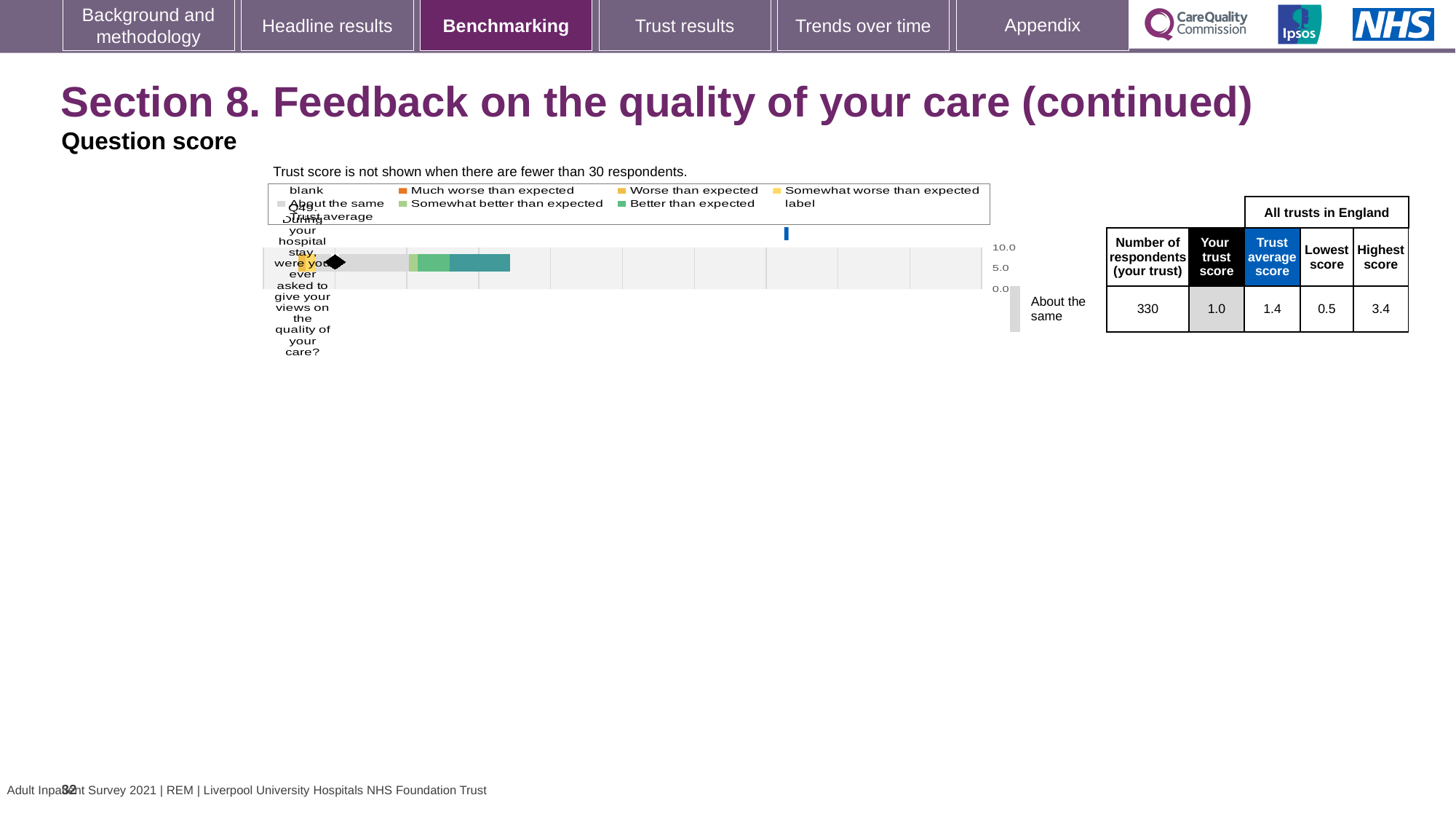
How many questions (categories) are plotted in the bar chart? 1 What benchmark category is shown beside the chart for Q49? About the same In the table next to the chart, what is the trust average score for Q49? 1.4 In the table next to the chart, what is your trust score for Q49? 1.0 Which question is plotted in the bar chart? Q49. During your hospital stay, were you ever asked to give your views on the quality of your care? In the table next to the chart, what is the number of respondents for your trust? 330 Which is larger for Q49: your trust score or the trust average score? trust average score In the table next to the chart, what is the lowest score among all trusts in England? 0.5 What is the difference between the highest score and the lowest score for Q49 in the table? 2.9 What is the highest value shown on the chart's axis? 10.0 In the table next to the chart, what is the highest score among all trusts in England? 3.4 What kind of chart is shown on the slide? bar chart